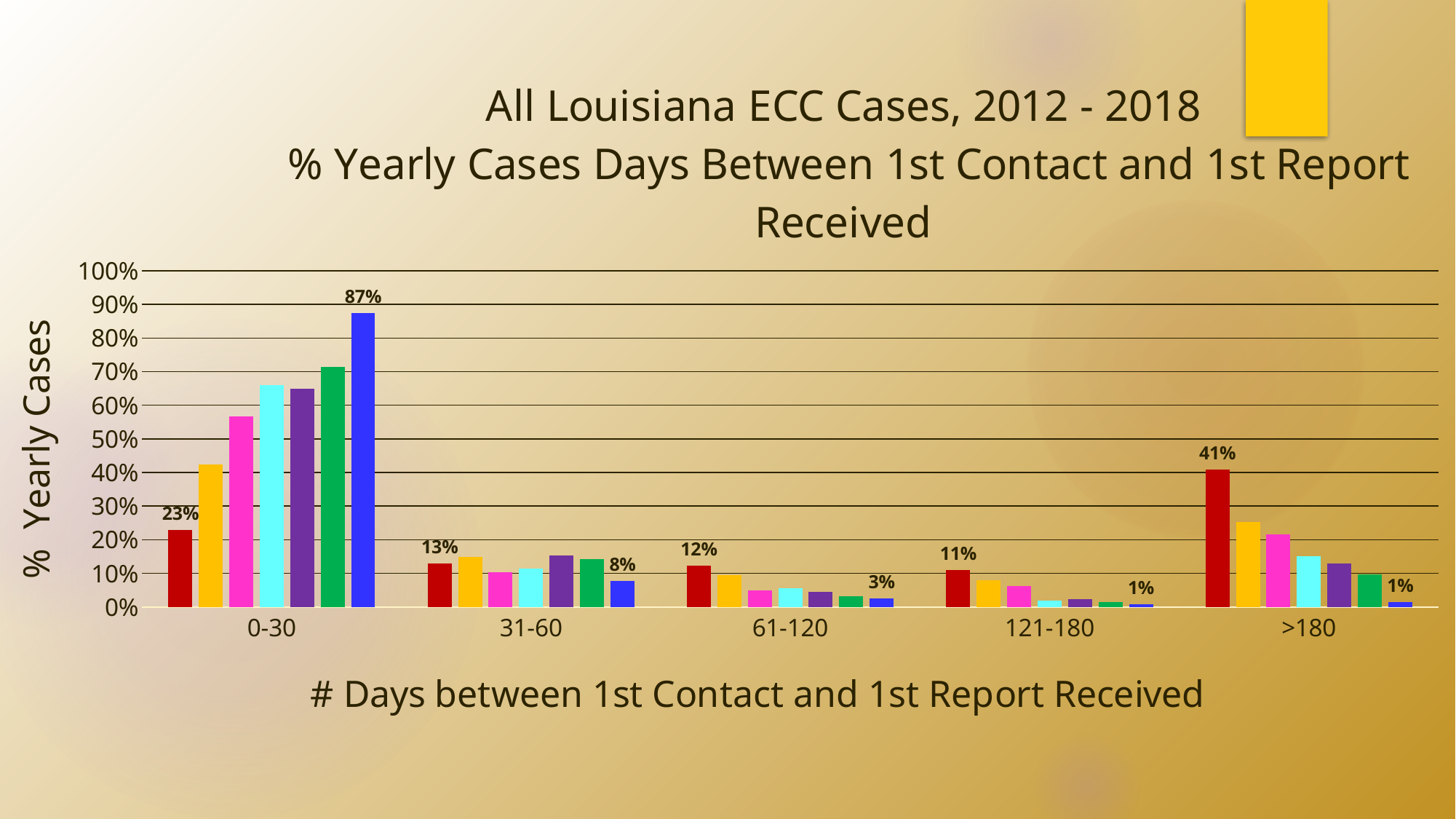
What is the value of the labelled blue (last) bar in the 61-120 category? 3% What is the difference between the labelled blue bar (87%) and the labelled red bar (23%) in the 0-30 category? 64% Is the value of the orange bar in the >180 category greater or less than 30%? less Is the value of the green bar in the 0-30 category greater or less than 60%? greater What is the value of the labelled red (first) bar in the 0-30 category? 23% What is the value of the labelled red (first) bar in the 121-180 category? 11% How many day-range categories are shown on the x axis? 5 What is the value of the labelled red (first) bar in the >180 category? 41% What kind of chart is shown on the slide? bar chart Which is larger in the 31-60 category: the labelled red bar or the labelled blue bar? the red bar (13%) What is the value of the labelled blue (last) bar in the 0-30 category? 87% What is the label of the x axis? # Days between 1st Contact and 1st Report Received